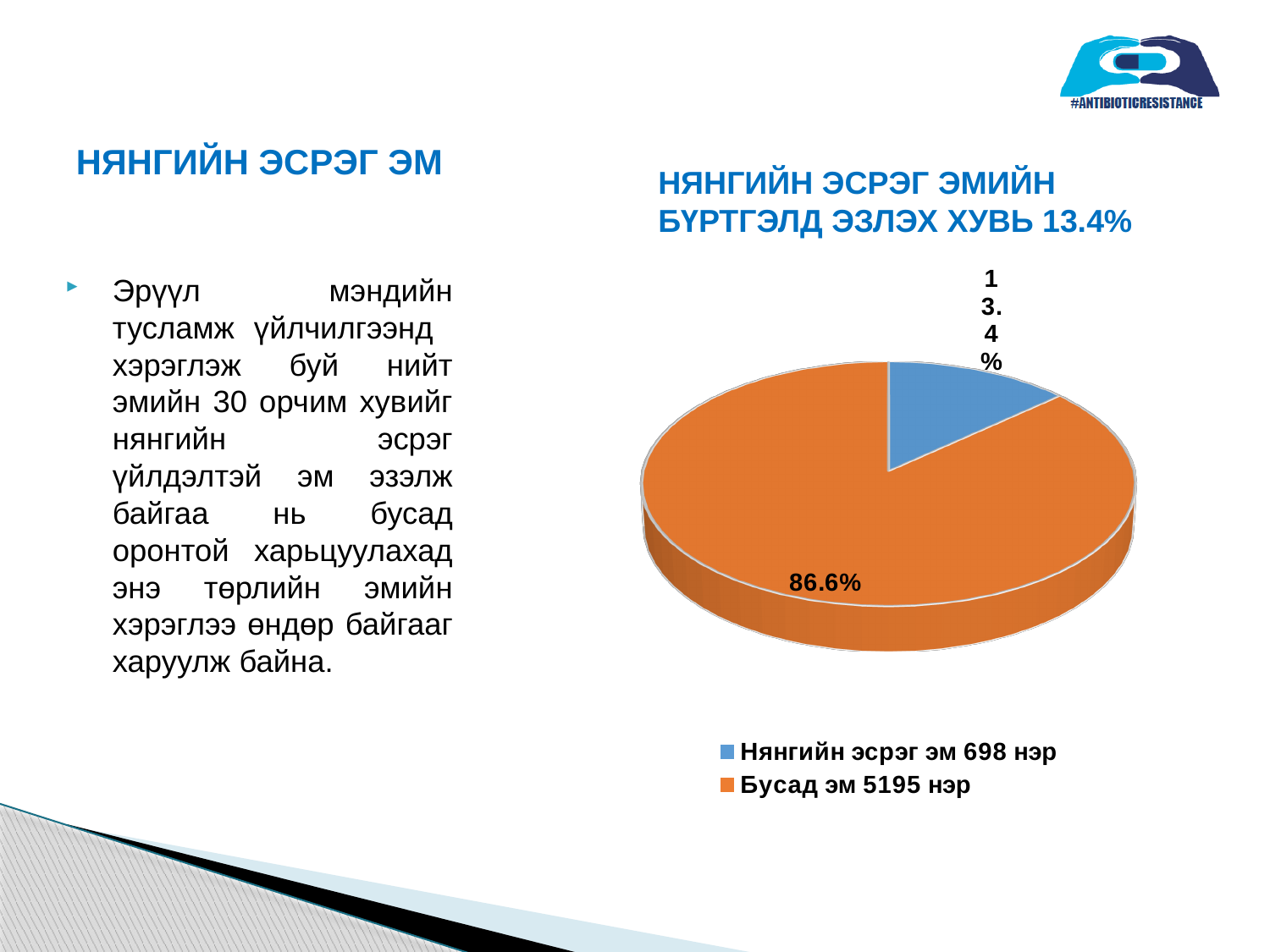
According to the legend, how many items (нэр) are in the 'Бусад эм' category? 5195 Which slice of the pie chart is the largest? Бусад эм 5195 нэр Which slice of the pie chart is the smallest? Нянгийн эсрэг эм 698 нэр What percentage share does the slice 'Нянгийн эсрэг эм 698 нэр' have in the pie chart? 13.4% What is the title of the pie chart? НЯНГИЙН ЭСРЭГ ЭМИЙН БҮРТГЭЛД ЭЗЛЭХ ХУВЬ 13.4% How many entries does the legend of the pie chart list? 2 What kind of chart is shown on the slide? Pie chart Which is larger in the pie chart: the 'Нянгийн эсрэг эм' slice or the 'Бусад эм' slice? Бусад эм What percentage share does the slice 'Бусад эм 5195 нэр' have in the pie chart? 86.6% What is the difference in percentage points between the 'Бусад эм' slice and the 'Нянгийн эсрэг эм' slice? 73.2 How many slices does the pie chart have? 2 What colour is the 'Нянгийн эсрэг эм 698 нэр' slice in the pie chart? Blue